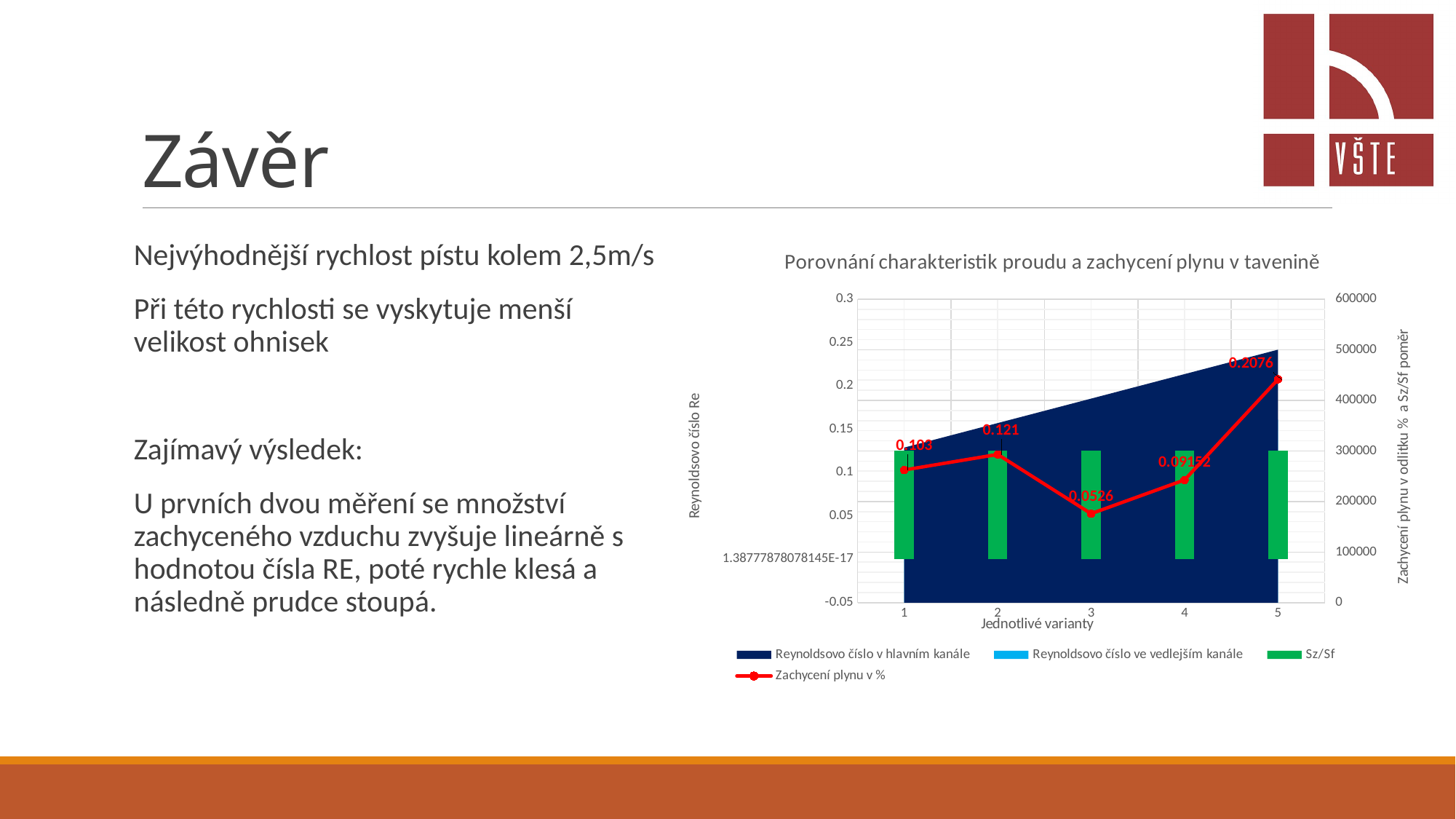
What is the difference between the Zachycení plynu v % values for variant 5 and variant 4? 0.11608 Does the Reynoldsovo číslo v hlavním kanále area rise or fall from variant 1 to variant 5? Rise Which variant has the lowest value of Zachycení plynu v %? 3 What is the value of Zachycení plynu v % for variant 5? 0.2076 What is the title of the chart? Porovnání charakteristik proudu a zachycení plynu v tavenině Which variant has a larger Zachycení plynu v % value, variant 2 or variant 4? Variant 2 Which variant has the highest value of Zachycení plynu v %? 5 What is the value of Zachycení plynu v % for variant 3? 0.0526 How many series does the legend list? 4 What is the value of Zachycení plynu v % for variant 1? 0.103 How many variants are shown on the x axis? 5 What is the difference between the Zachycení plynu v % values for variant 2 and variant 1? 0.018